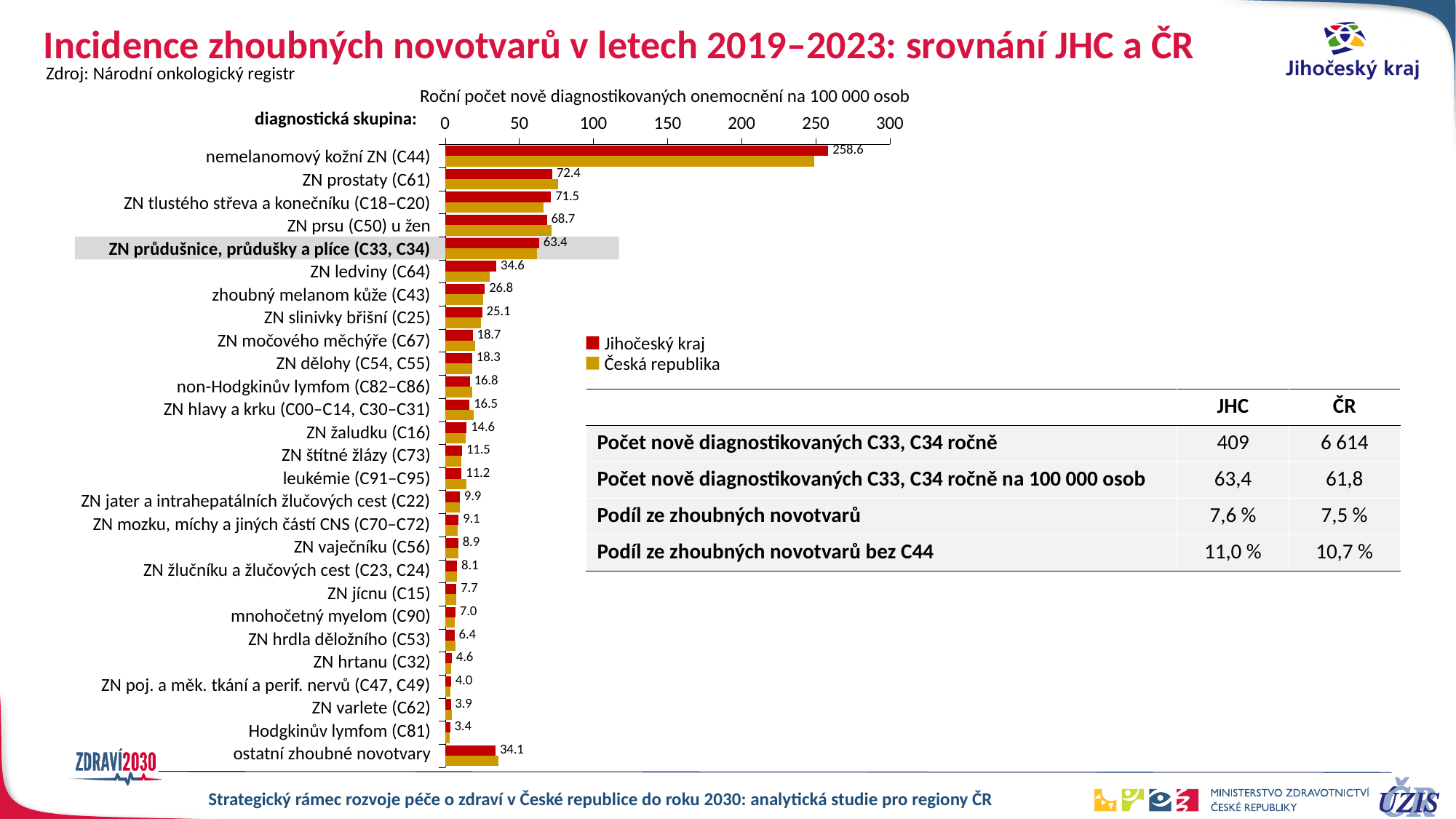
Which diagnostic group has the lowest value for Jihočeský kraj? Hodgkinův lymfom (C81) Which has a larger Jihočeský kraj value: ZN prsu (C50) u žen or ZN ledviny (C64)? ZN prsu (C50) u žen How many series does the legend list? 2 What is the difference between the Jihočeský kraj values for ZN prostaty (C61) and ZN tlustého střeva a konečníku (C18–C20)? 0.9 How many diagnostic groups are shown on the chart? 27 What is the difference between the Jihočeský kraj values for nemelanomový kožní ZN (C44) and ZN prostaty (C61)? 186.2 What is the value for Jihočeský kraj for ZN průdušnice, průdušky a plíce (C33, C34)? 63.4 What is the value for Jihočeský kraj for leukémie (C91–C95)? 11.2 Which diagnostic group has the highest value for Jihočeský kraj? nemelanomový kožní ZN (C44) Is the Česká republika value for nemelanomový kožní ZN (C44) greater or less than 200? greater What is the value for Jihočeský kraj for ZN prostaty (C61)? 72.4 What kind of chart is shown on the slide? bar chart